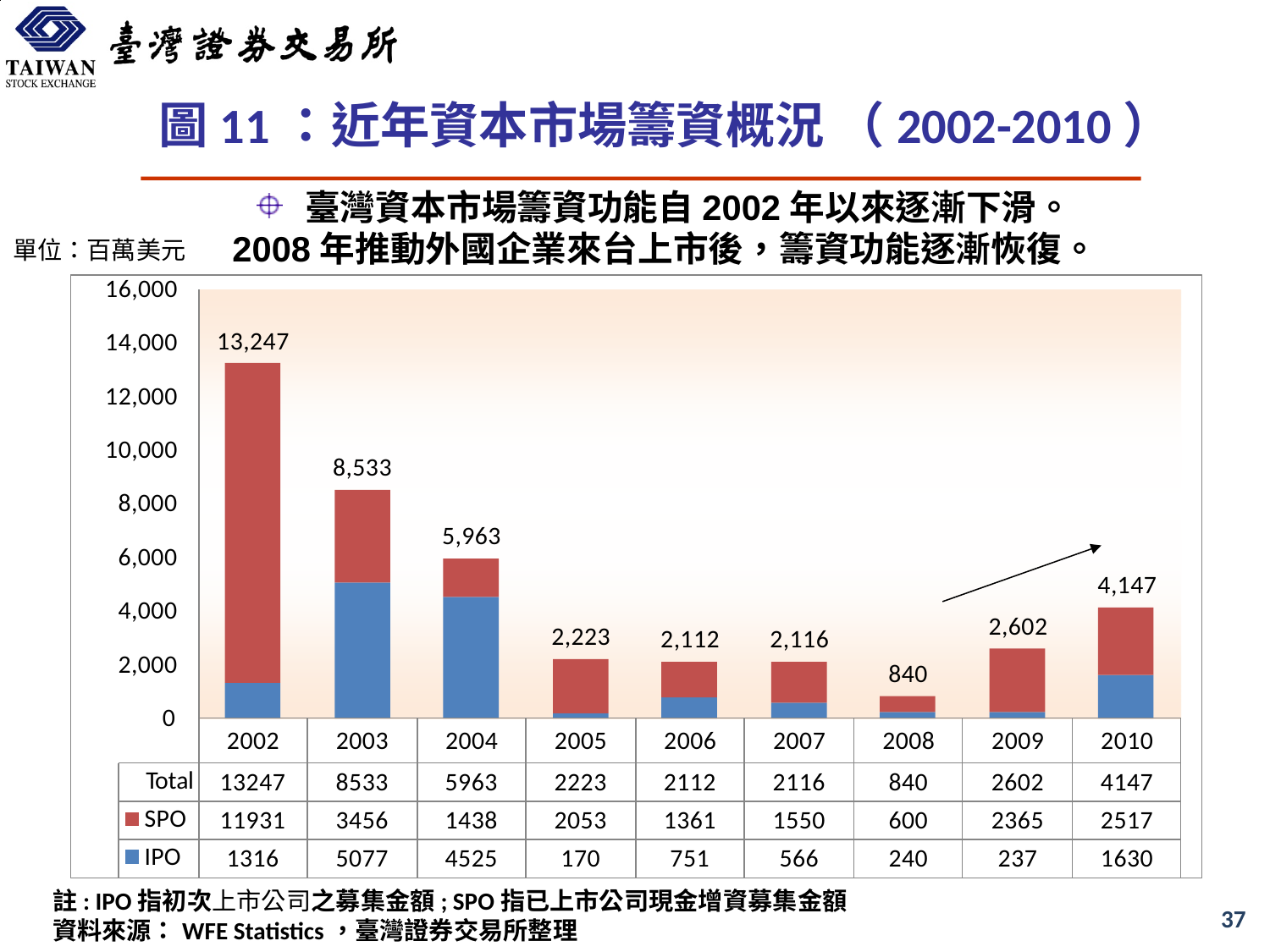
In 2004, which is larger, IPO or SPO? IPO What is the total of the stacked bar for 2010? 4,147 What is the IPO value for 2003? 5077 What is the difference between the total for 2002 and the total for 2003? 4714 What kind of chart is this? stacked bar chart Which year has the highest total? 2002 What is the SPO value for 2010? 2517 How many series does the legend list? 2 Which year has the lowest total? 2008 Is the total for 2009 greater or less than 2,000? greater How many years are shown on the x axis? 9 Which year has the lowest IPO value? 2005